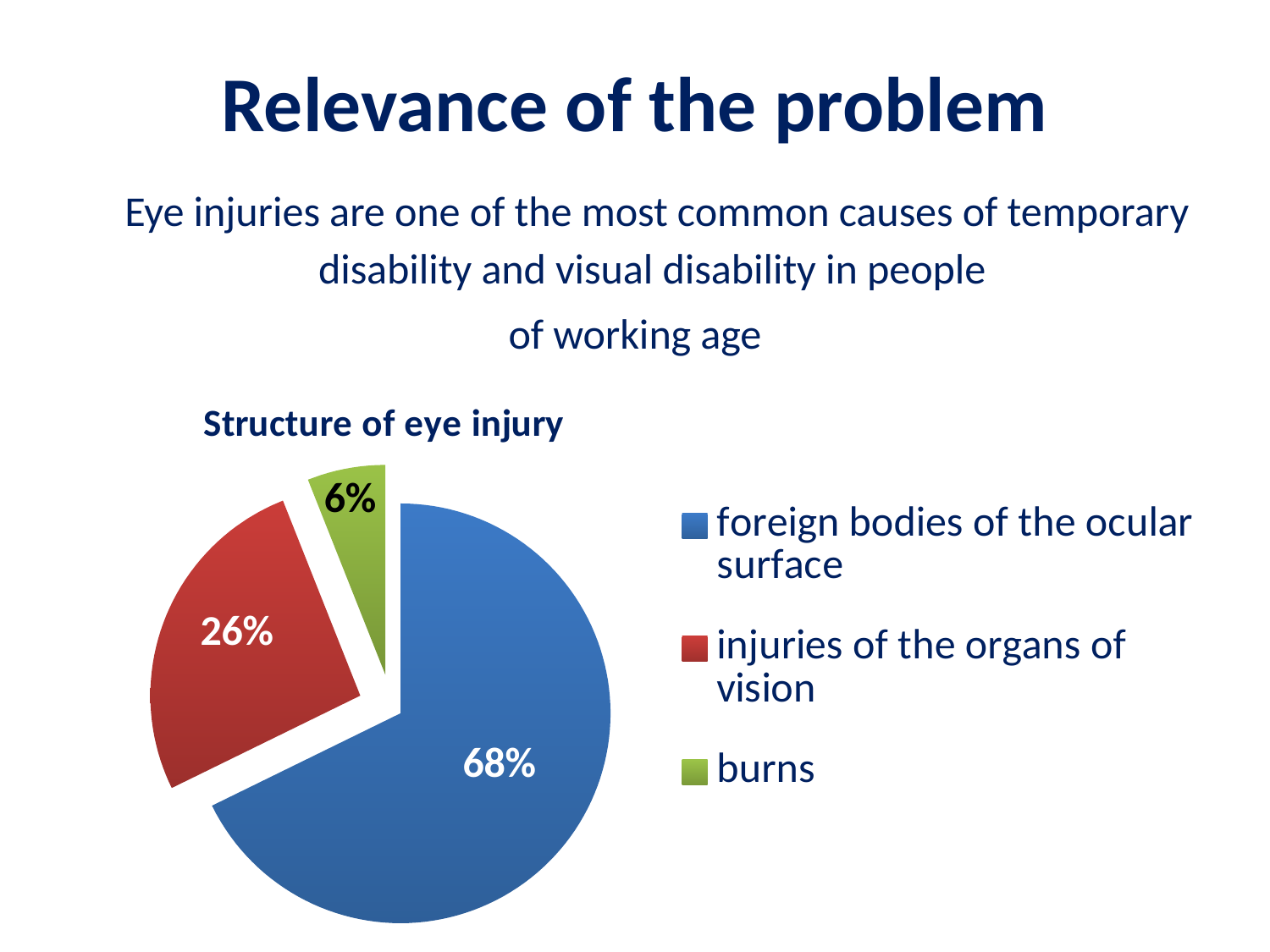
Which category has the smallest share of the pie? burns What colour is the slice for burns? green Which is larger: the share for injuries of the organs of vision or the share for burns? injuries of the organs of vision What is the title of the chart? Structure of eye injury What is the difference in percentage points between injuries of the organs of vision and burns? 20 Which category has the largest share of the pie? foreign bodies of the ocular surface What share of eye injuries is attributed to foreign bodies of the ocular surface? 68% What share of eye injuries is attributed to injuries of the organs of vision? 26% What share of eye injuries is attributed to burns? 6% What is the difference in percentage points between foreign bodies of the ocular surface and injuries of the organs of vision? 42 How many categories does the pie chart show? 3 What kind of chart is shown on the slide? pie chart